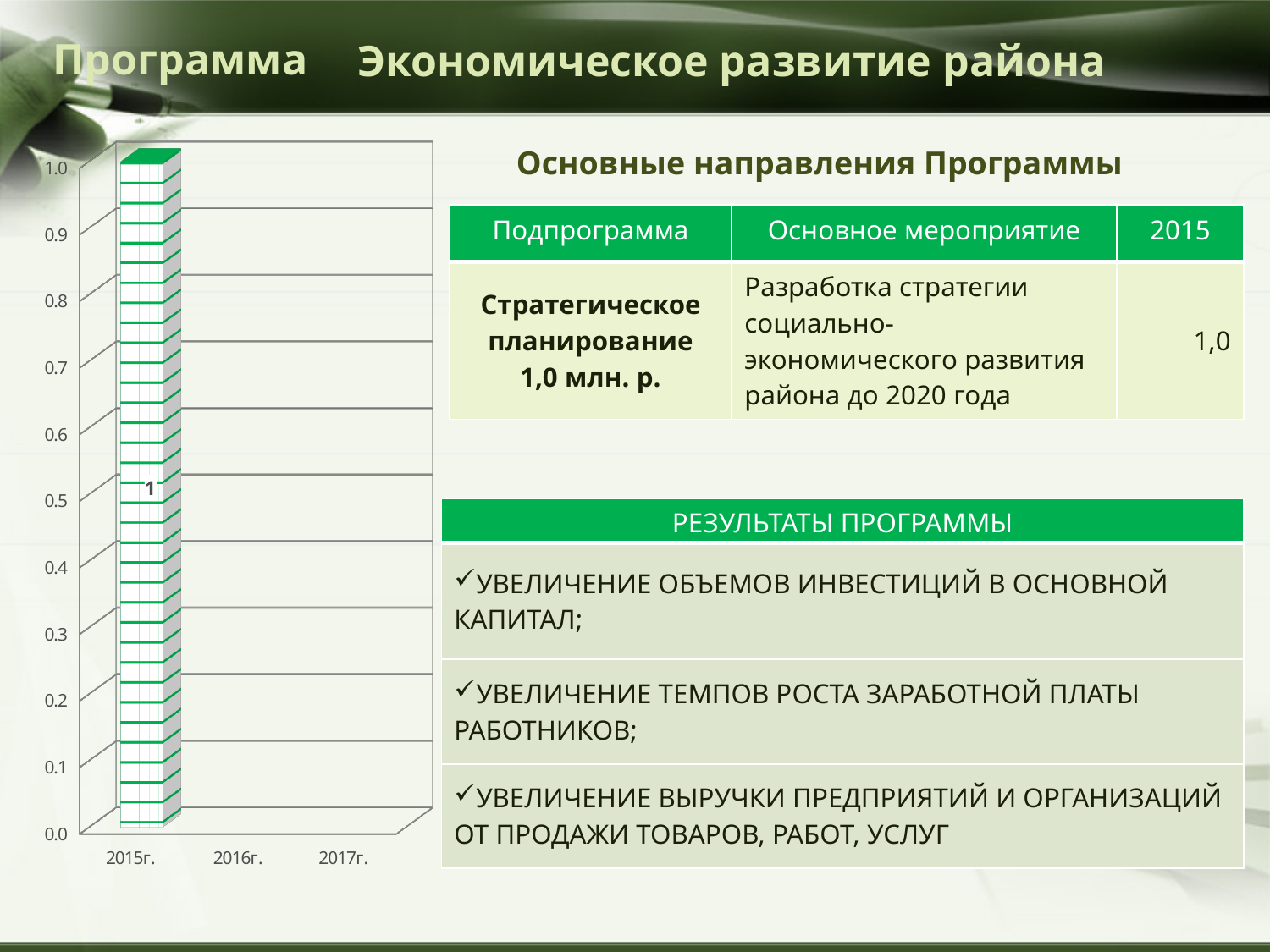
What is the value shown on the bar for 2015г.? 1 Is the value for 2015г. greater or less than 0.5? greater How many categories are shown on the x axis of the chart? 3 Which is larger, the value for 2015г. or the value for 2016г.? 2015г. What type of chart is shown on the left of the slide? bar chart What is the first category label on the x axis of the chart? 2015г. What is the highest tick value shown on the y axis of the chart? 1.0 Which category has the highest value in the chart? 2015г.